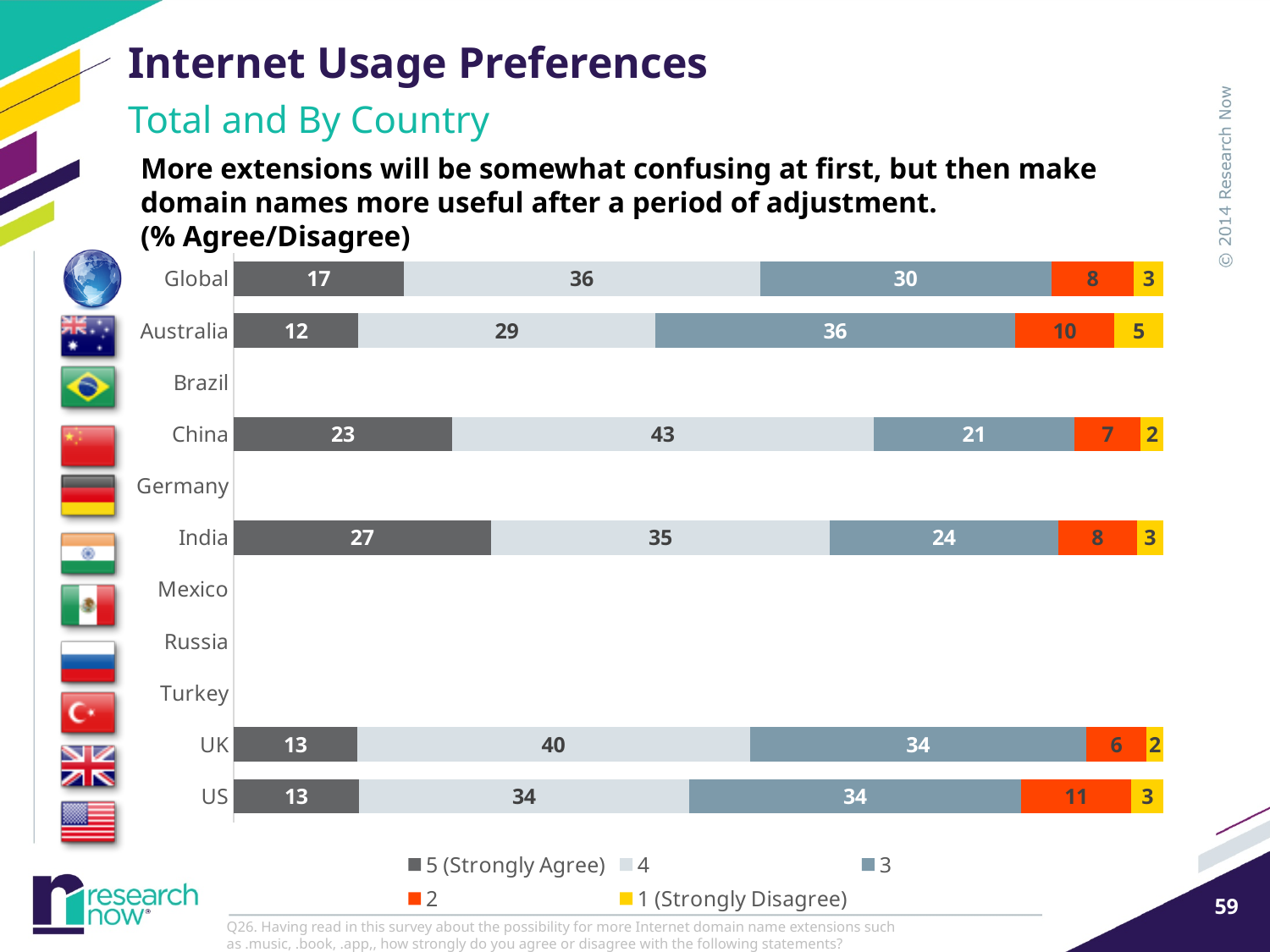
Which country has the lowest value for 5 (Strongly Agree)? Australia What is the value for 1 (Strongly Disagree) for Australia? 5 What kind of chart is shown on the slide? Stacked bar chart What is the difference between the 4 values for China and Australia? 14 Which is larger, the 3 value for Australia or the 3 value for China? Australia Which country has the highest value for 5 (Strongly Agree)? India What is the value for 2 for the US? 11 Which legend entry is shown in yellow? 1 (Strongly Disagree) What is the value for 5 (Strongly Agree) for India? 27 What is the value for 4 for China? 43 How many series does the legend list? 5 What is the total of the 5 (Strongly Agree) and 4 segments for the UK? 53